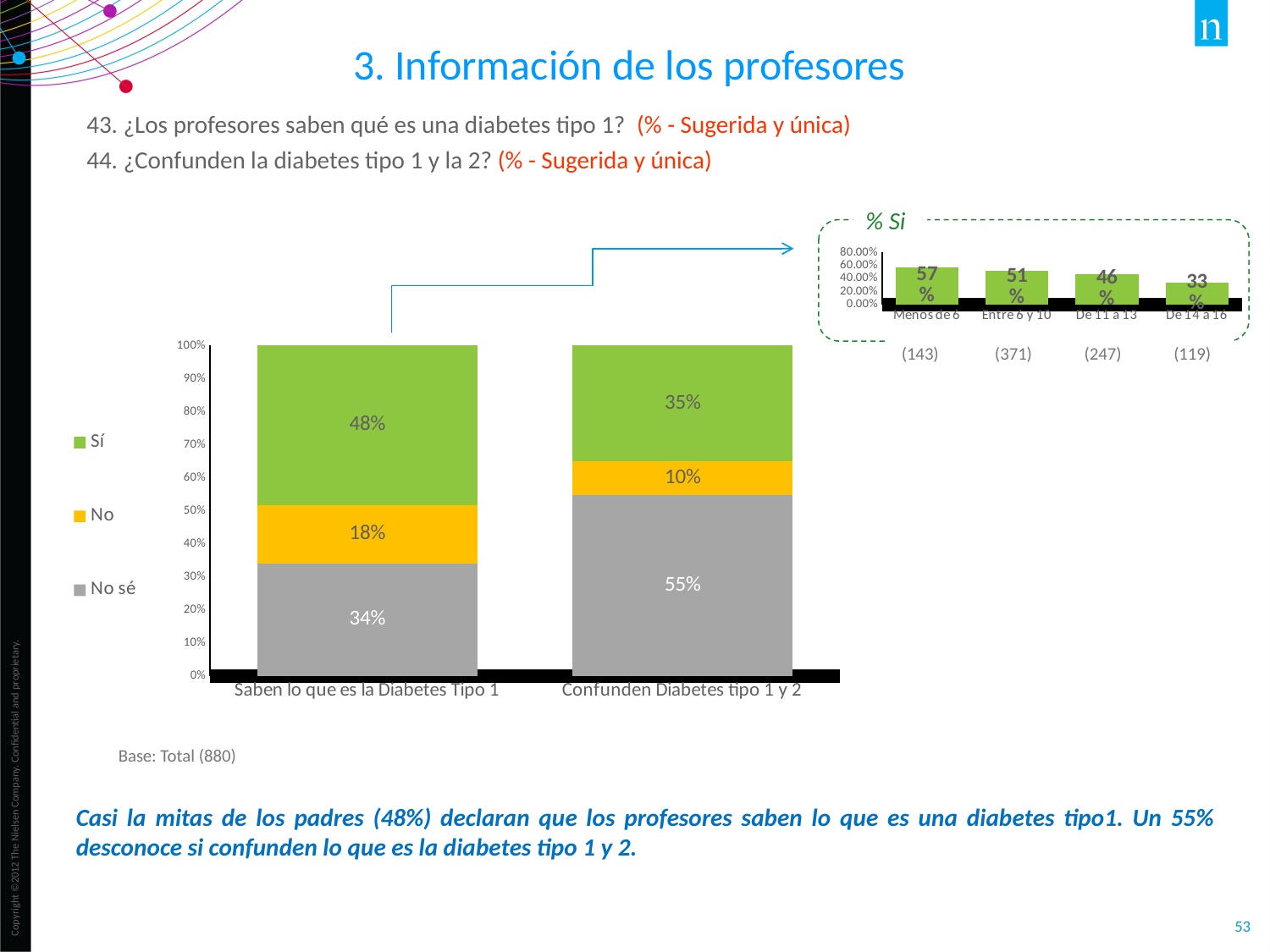
What type of chart is the main chart on the slide? Stacked bar chart In the '% Si' chart, what is the value for 'Entre 6 y 10'? 51% In the main stacked bar chart, what percentage answered 'No sé' for 'Confunden Diabetes tipo 1 y 2'? 55% How many series does the legend of the main stacked bar chart list? 3 In the main stacked bar chart, what percentage answered 'Sí' for 'Saben lo que es la Diabetes Tipo 1'? 48% In the '% Si' chart, which age group has the lowest value? De 14 a 16 In the main stacked bar chart, what percentage answered 'No' for 'Saben lo que es la Diabetes Tipo 1'? 18% In the main stacked bar chart, what is the difference between the 'Sí' values for 'Saben lo que es la Diabetes Tipo 1' and 'Confunden Diabetes tipo 1 y 2'? 13% How many categories are shown in the '% Si' chart? 4 In the main stacked bar chart, which category has the larger 'No sé' value? Confunden Diabetes tipo 1 y 2 In the '% Si' chart, do the values rise or fall from 'Menos de 6' to 'De 14 a 16'? Fall In the '% Si' chart, which age group has the highest value? Menos de 6